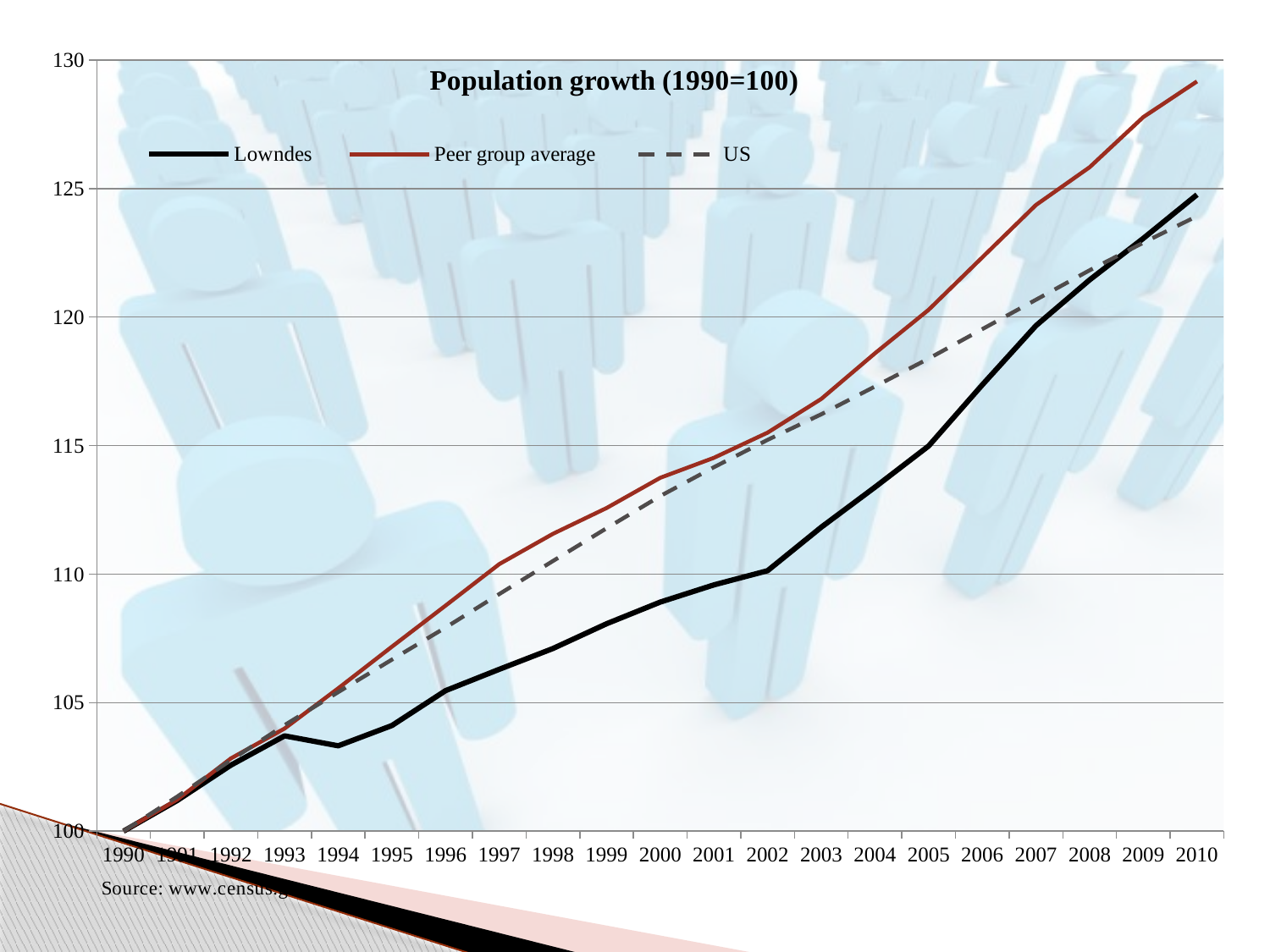
Which series has the highest value in 2010? Peer group average In 2000, which is larger: Lowndes or Peer group average? Peer group average What is the title of the chart? Population growth (1990=100) Which series is drawn as a dashed line? US What is the value for Lowndes in 1990? 100 What kind of chart is shown on the slide? line chart Is the value for Peer group average in 2010 greater or less than 125? greater Which series has the lowest value in 2005? Lowndes Is the value for US in 2010 greater or less than 125? less How many years are shown along the x axis? 21 How many series does the legend list? 3 Does the Lowndes line generally rise or fall from 1990 to 2010? rise